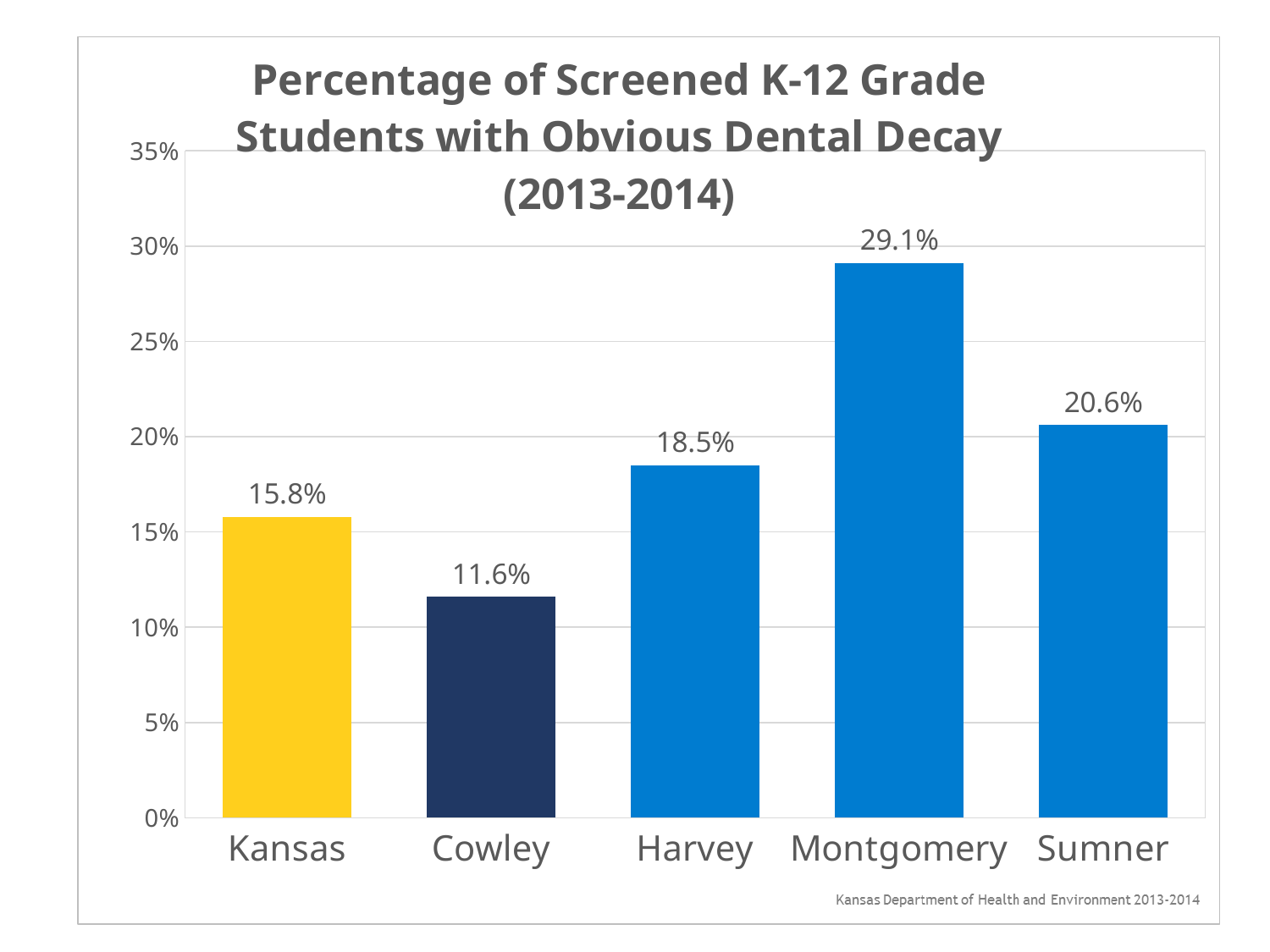
Which category has the highest value? Montgomery What is the difference between the values for Montgomery and Kansas? 13.3% Which category has the lowest value? Cowley What is the value for Kansas? 15.8% Is the value for Harvey greater or less than 20%? less Which is larger, the value for Harvey or the value for Sumner? Sumner How many categories are shown on the x axis? 5 What is the value for Cowley? 11.6% What is the difference between the values for Harvey and Cowley? 6.9% What kind of chart is shown on the slide? bar chart What is the value for Montgomery? 29.1% What is the value for Sumner? 20.6%